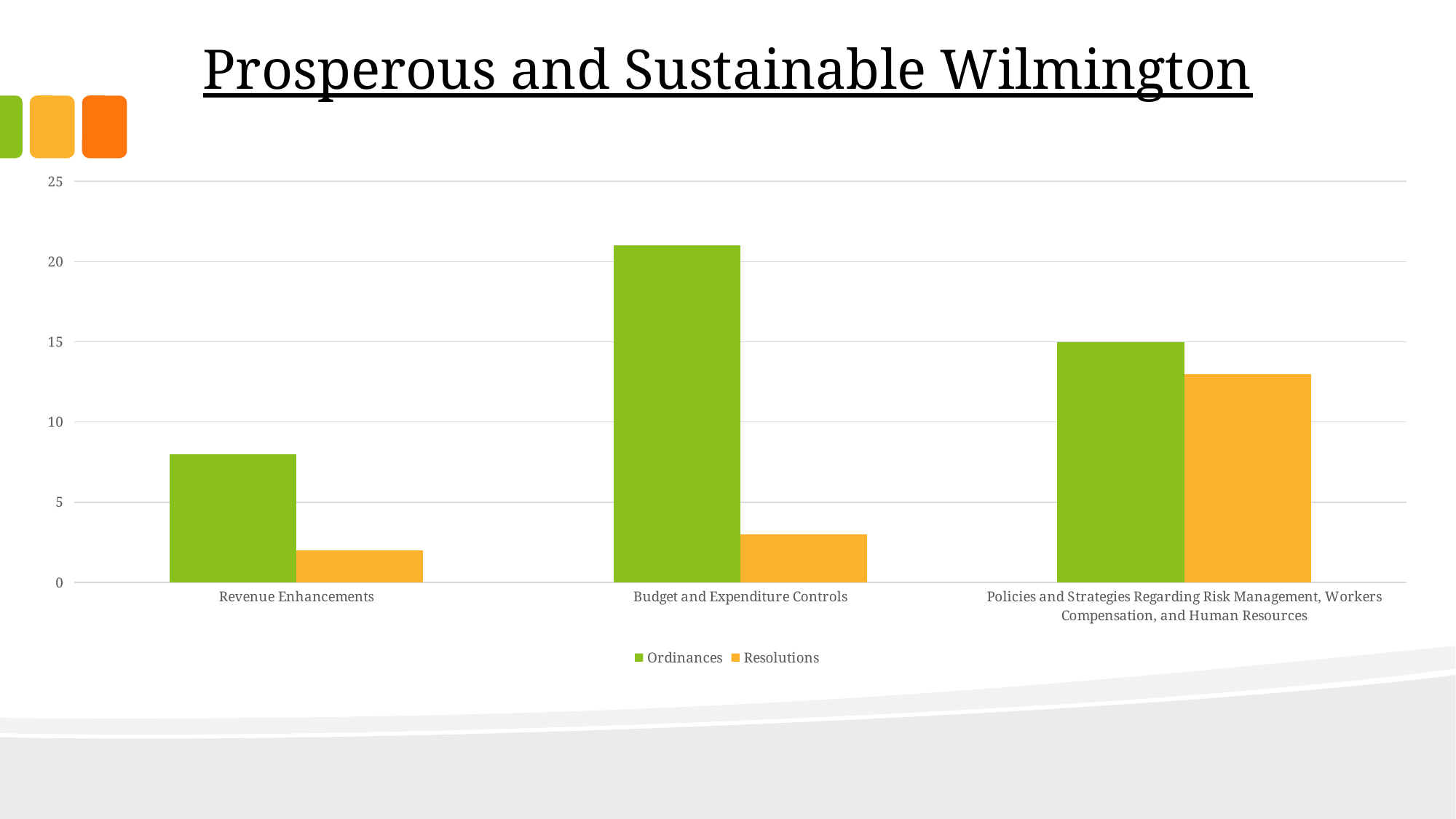
Which category has the highest Ordinances value? Budget and Expenditure Controls Is the Resolutions value for Revenue Enhancements greater or less than 5? less How many series does the legend list? 2 Is the Ordinances value for Revenue Enhancements greater or less than 10? less Is the Ordinances value for Budget and Expenditure Controls greater or less than 20? greater Which category has the highest Resolutions value? Policies and Strategies Regarding Risk Management, Workers Compensation, and Human Resources Which category has the lowest Resolutions value? Revenue Enhancements How many categories are shown on the x axis? 3 What is the Ordinances value for Policies and Strategies Regarding Risk Management, Workers Compensation, and Human Resources? 15 What kind of chart is shown on the slide? bar chart Which series is shown in green in the legend? Ordinances Which is larger for Budget and Expenditure Controls, Ordinances or Resolutions? Ordinances